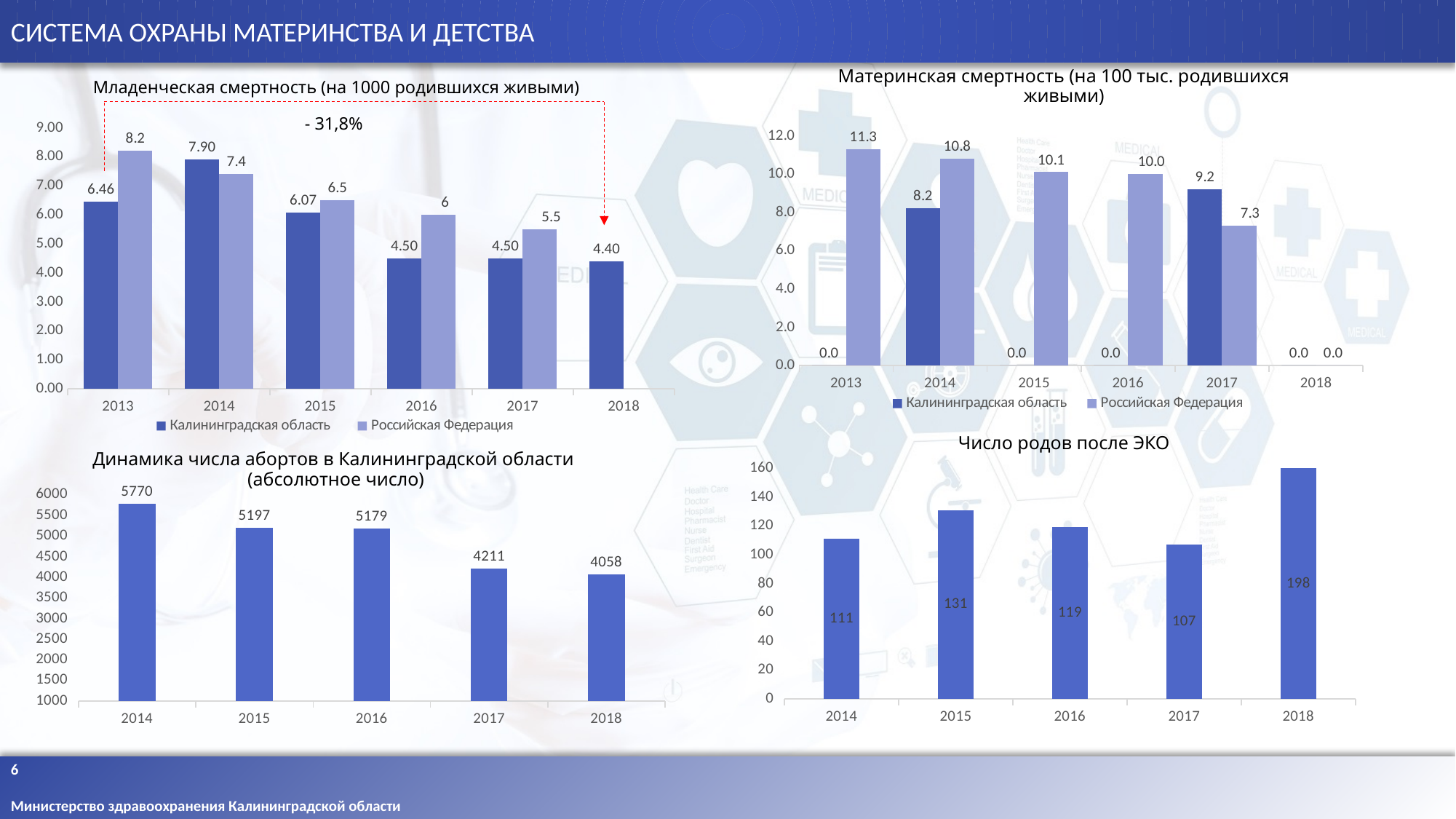
In the chart 'Число родов после ЭКО', which year has the highest value? 2018 In the chart 'Материнская смертность (на 100 тыс. родившихся живыми)', which is larger in 2017: Калининградская область or Российская Федерация? Калининградская область In the chart 'Динамика числа абортов в Калининградской области (абсолютное число)', what is the difference between the 2014 and 2018 values? 1712 In the chart 'Младенческая смертность (на 1000 родившихся живыми)', what is the value for Калининградская область in 2014? 7.90 In the chart 'Материнская смертность (на 100 тыс. родившихся живыми)', what is the value for Российская Федерация in 2015? 10.1 In the chart 'Материнская смертность (на 100 тыс. родившихся живыми)', which year has the highest value for Российская Федерация? 2013 In the chart 'Динамика числа абортов в Калининградской области (абсолютное число)', what is the value for 2017? 4211 In the chart 'Младенческая смертность (на 1000 родившихся живыми)', how many series does the legend list? 2 What kind of chart is 'Число родов после ЭКО'? bar chart In the chart 'Младенческая смертность (на 1000 родившихся живыми)', what is the value for Российская Федерация in 2013? 8.2 In the chart 'Младенческая смертность (на 1000 родившихся живыми)', which year has the lowest value for Калининградская область? 2018 In the chart 'Динамика числа абортов в Калининградской области (абсолютное число)', do the values rise or fall from 2014 to 2018? fall